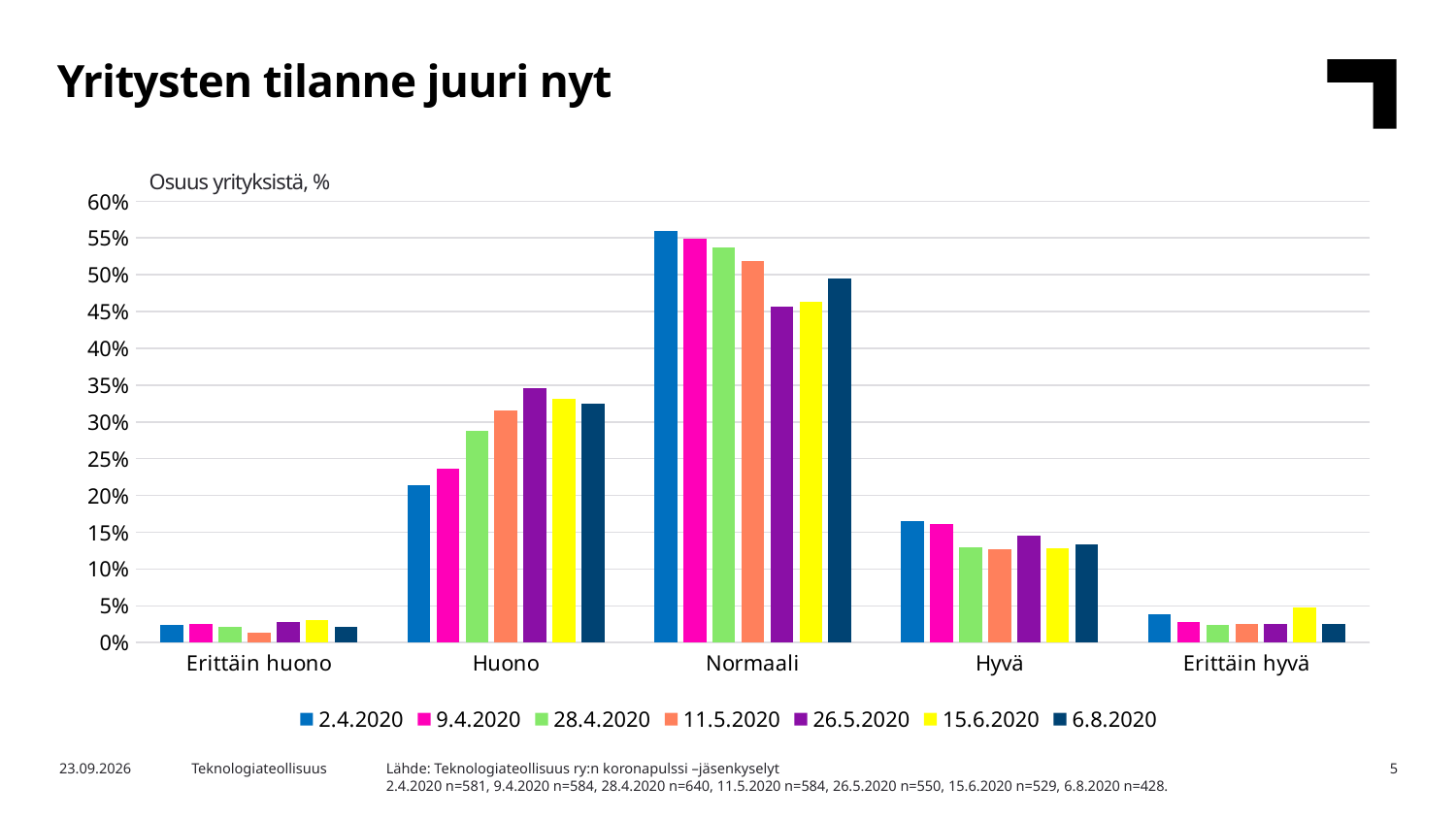
How many categories are shown on the x axis of the chart? 5 Is the value for Hyvä in the 2.4.2020 series greater or less than 20%? less For the Normaali category, which is larger: the 2.4.2020 value or the 6.8.2020 value? 2.4.2020 Is the value for Erittäin huono in the 11.5.2020 series greater or less than 5%? less What kind of chart is shown on the slide? bar chart Is the value for Huono in the 26.5.2020 series greater or less than 30%? greater Within the Huono category, which series has the lowest value? 2.4.2020 For the Huono category, which is larger: the 2.4.2020 value or the 26.5.2020 value? 26.5.2020 Which category has the highest value for the 2.4.2020 series? Normaali How many series does the chart legend list? 7 What is the label shown above the y axis of the chart? Osuus yrityksistä, %